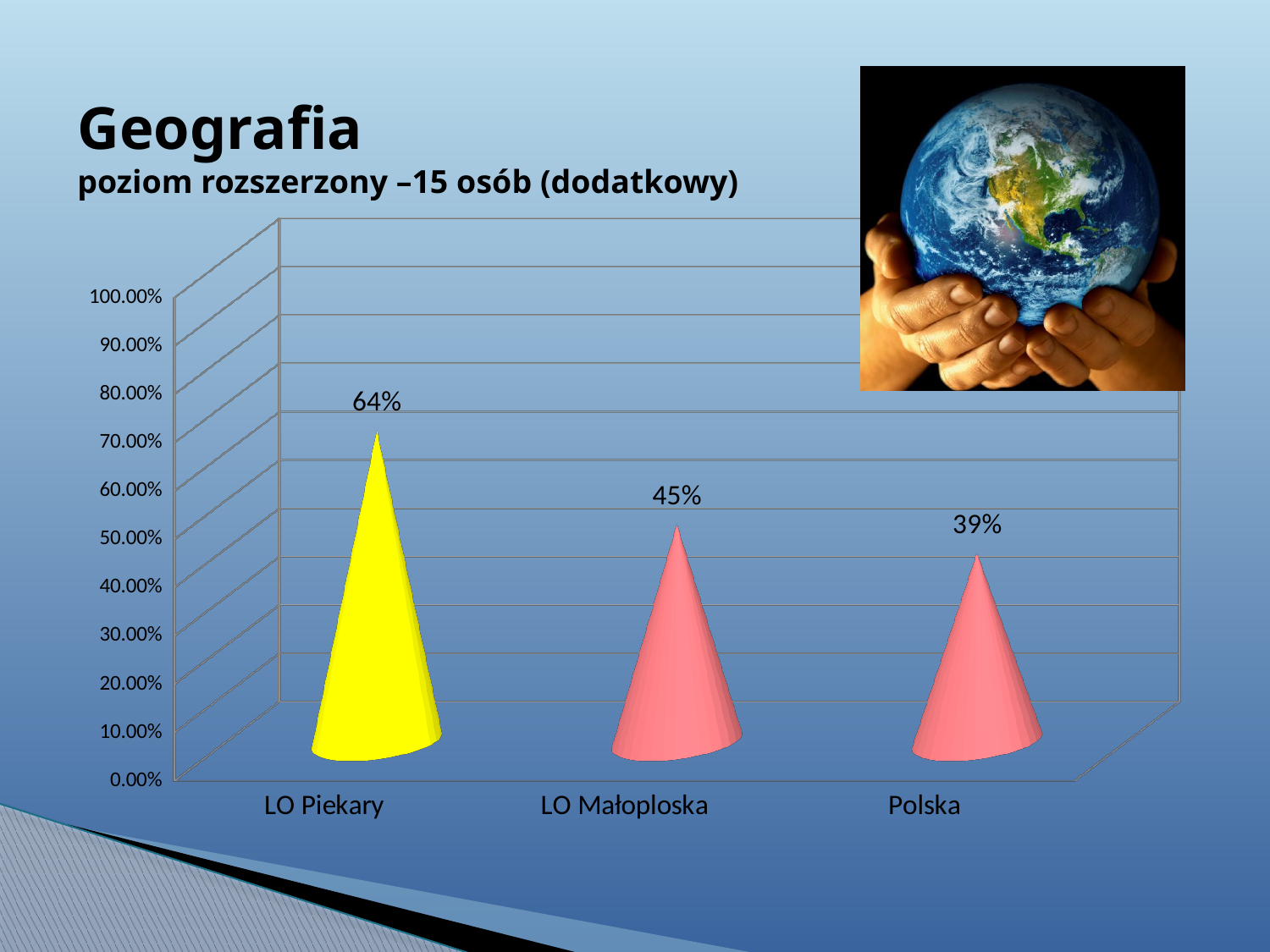
What is the value for Polska? 39% What is the value for LO Małoploska? 45% Is the value for LO Piekary greater or less than 50.00%? greater Do the values rise or fall from left to right along the x axis? fall What is the difference between the values for LO Małoploska and Polska? 6% What is the difference between the values for LO Piekary and Polska? 25% What is the value for LO Piekary? 64% Which is larger, the value for LO Małoploska or the value for Polska? LO Małoploska Which category has the lowest value? Polska What kind of chart is shown on the slide? bar chart Which category has the highest value? LO Piekary How many categories are shown on the x axis? 3